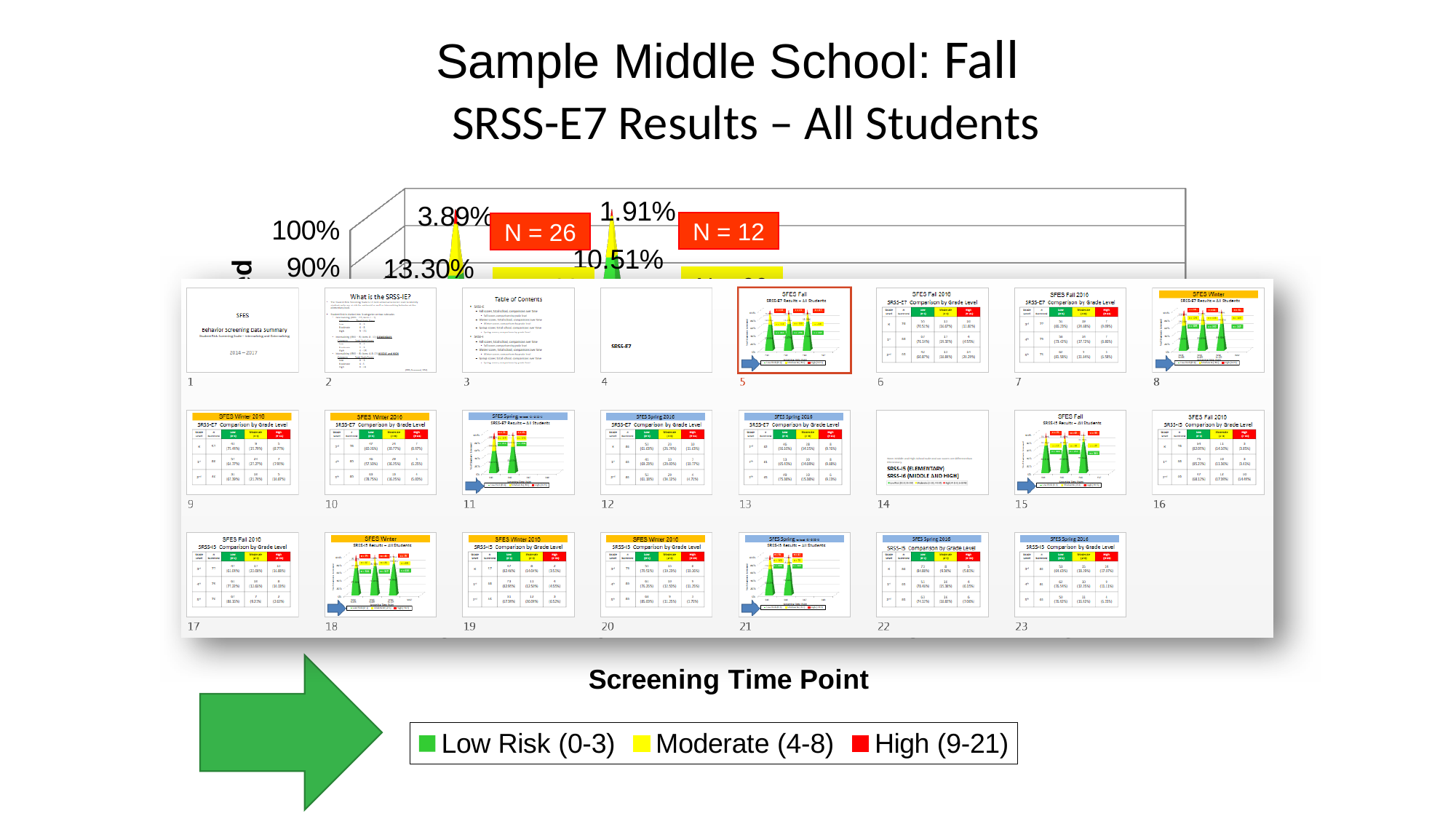
Which colour represents the High (9-21) series in the legend? red What is the difference between the two High (9-21) data labels, 3.89% and 1.91%? 1.98% What kind of chart is shown on the slide? bar chart What is the difference between the two Moderate (4-8) data labels, 13.30% and 10.51%? 2.79% What is the title of the chart's x axis? Screening Time Point What N value is shown in the red box next to the 1.91% label? N = 12 What is the smallest percentage data label visible on the chart? 1.91% How many series does the chart legend list? 3 Which is larger, the 3.89% High value or the 1.91% High value? 3.89% What are the three legend entries of the chart? Low Risk (0-3), Moderate (4-8), High (9-21) What is the largest percentage data label visible on the chart? 13.30% What N value is shown in the red box next to the 3.89% label? N = 26